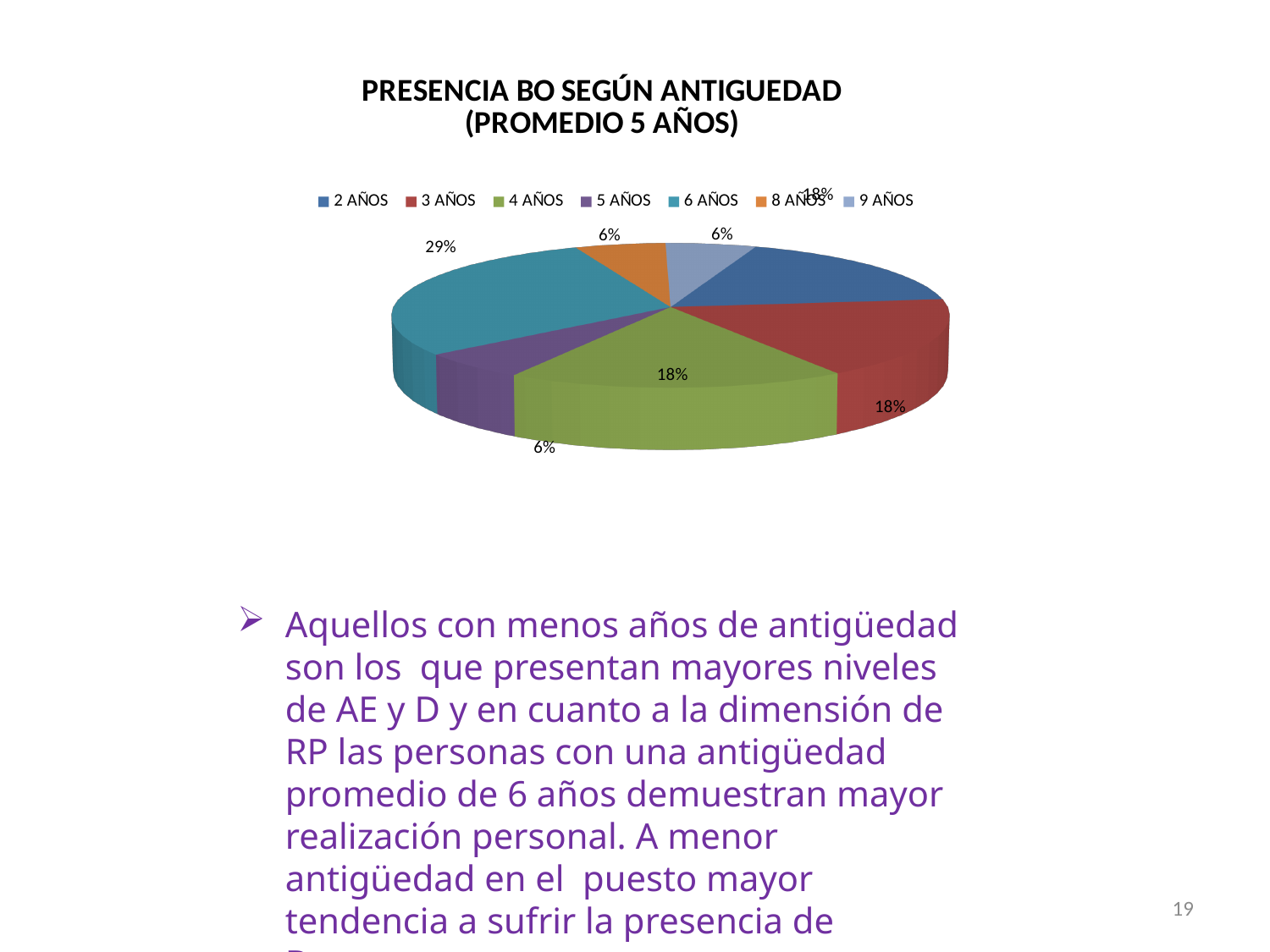
Which has a larger share, 6 AÑOS or 3 AÑOS? 6 AÑOS What percentage of the pie corresponds to 8 AÑOS? 6% What percentage of the pie corresponds to 3 AÑOS? 18% Which category has the largest share of the pie? 6 AÑOS What is the title of the chart? PRESENCIA BO SEGÚN ANTIGUEDAD (PROMEDIO 5 AÑOS) What type of chart is shown on the slide? Pie chart What is the difference in percentage points between the share for 6 AÑOS and the share for 4 AÑOS? 11 What percentage of the pie corresponds to 5 AÑOS? 6% What percentage of the pie corresponds to 6 AÑOS? 29% What percentage of the pie corresponds to 4 AÑOS? 18% How many entries does the legend list? 7 How many categories does the pie chart have? 7